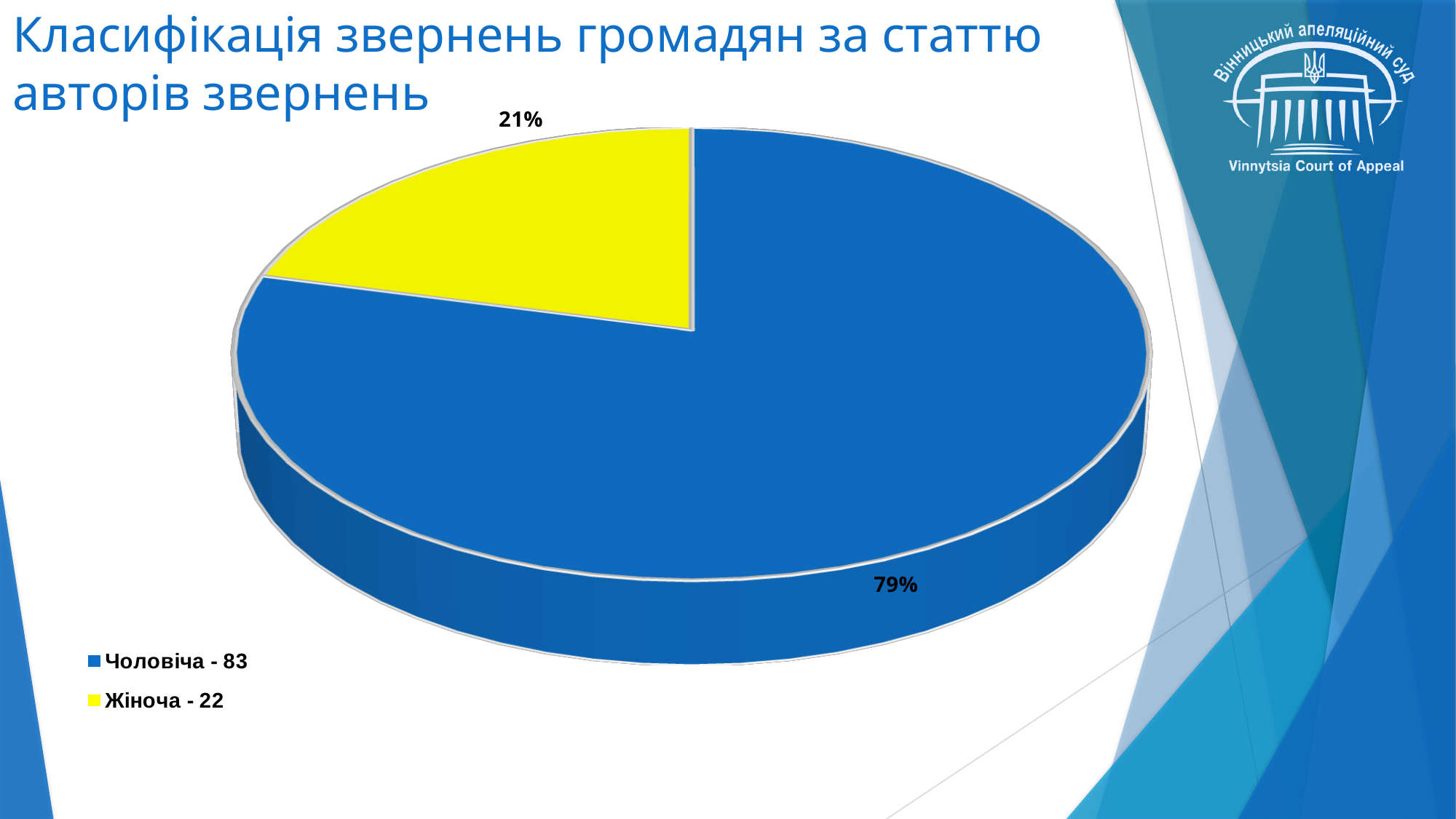
What is the difference between the counts for Чоловіча and Жіноча shown in the legend? 61 What count is shown in the legend for Чоловіча? 83 Which category has the largest share of the pie? Чоловіча What colour is the Жіноча slice? yellow What count is shown in the legend for Жіноча? 22 What kind of chart is shown on the slide? pie chart What percentage share does the Чоловіча slice have? 79% Which is larger, the Чоловіча slice or the Жіноча slice? Чоловіча How many slices does the pie chart have? 2 What is the difference in percentage points between the Чоловіча and Жіноча slices? 58% What percentage share does the Жіноча slice have? 21% Which category has the smallest share of the pie? Жіноча